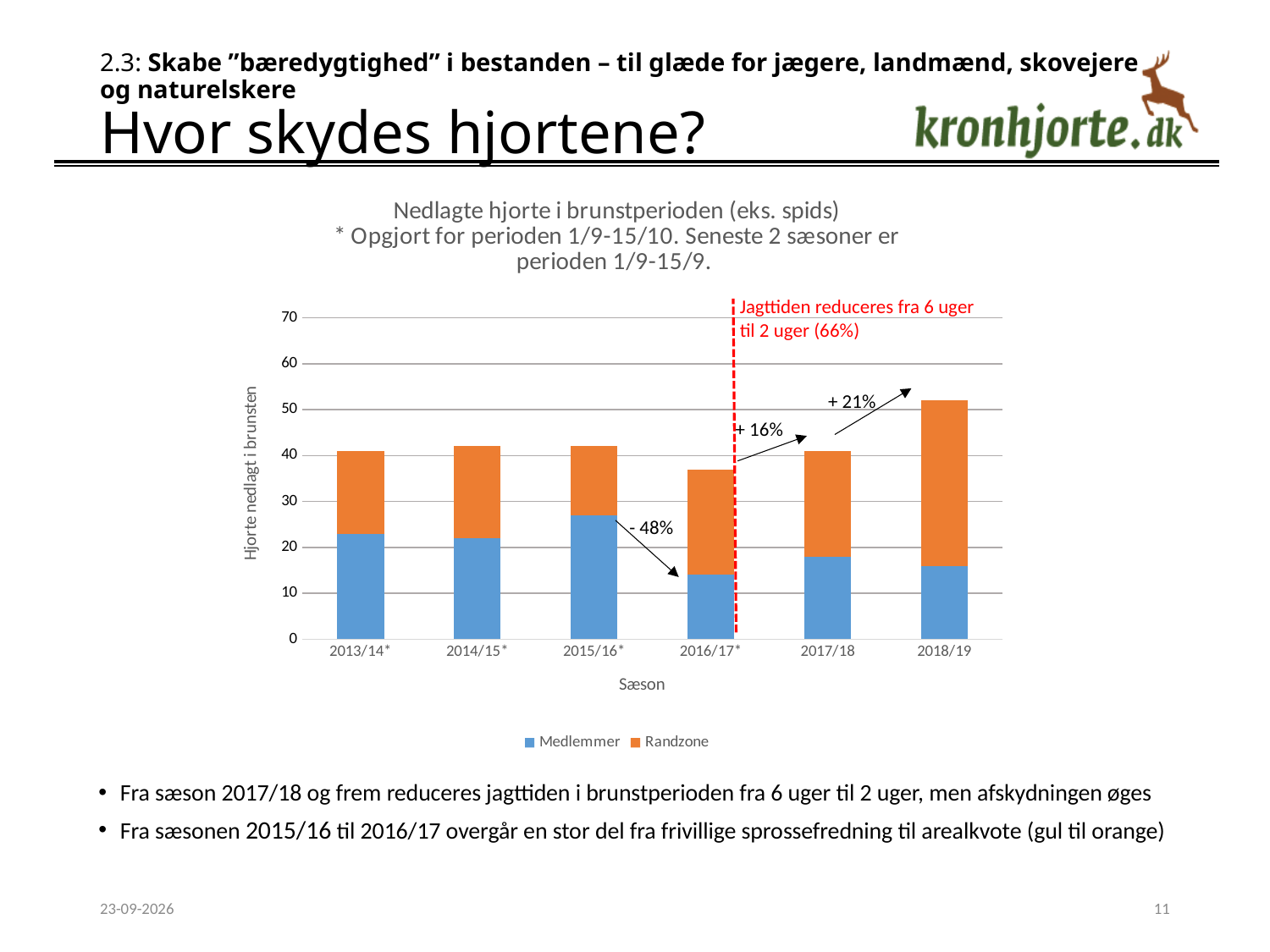
Which season has a larger total stacked bar, 2013/14* or 2018/19? 2018/19 How many seasons are shown on the x axis of the chart? 6 Which season has the lowest total number of deer shot in the rut (shortest stacked bar)? 2016/17* Which season has the highest Medlemmer value? 2015/16* How many series does the chart legend list? 2 Which season has a larger Medlemmer value, 2013/14* or 2016/17*? 2013/14* Is the total stacked value for 2016/17* greater or less than 40? less Which season has the highest total number of deer shot in the rut (tallest stacked bar)? 2018/19 Is the Medlemmer value for 2016/17* greater or less than 20? less Is the total stacked value for 2018/19 greater or less than 40? greater What kind of chart is shown on the slide? Stacked bar chart Which colour represents the Randzone series in the chart? Orange